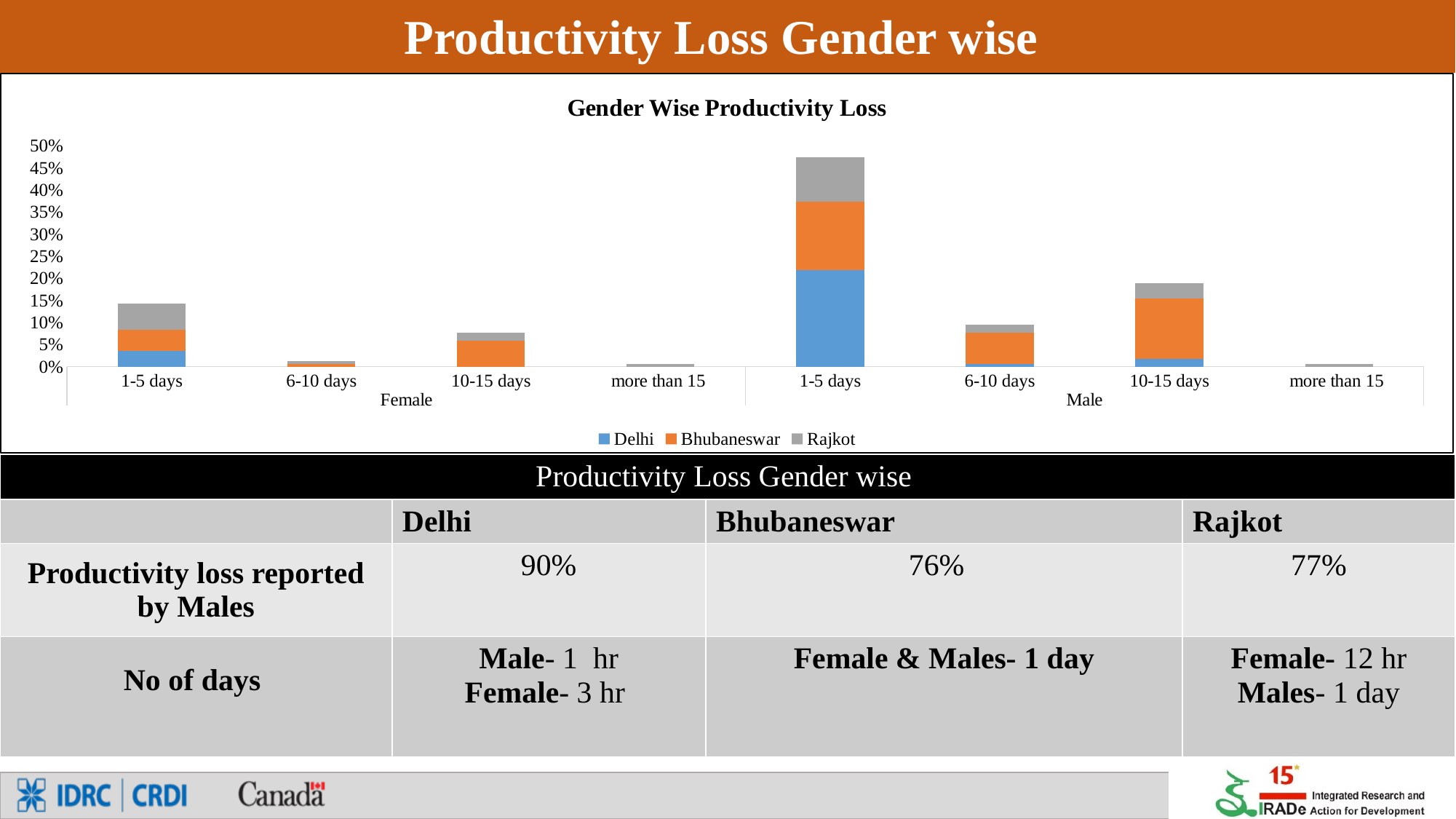
Which category has the tallest stacked bar in the chart? Male 1-5 days Is the total for the Female 1-5 days bar greater or less than 20%? less Is the total for the Female 6-10 days bar greater or less than 5%? less How many series does the chart legend list? 3 What is the title of the chart? Gender Wise Productivity Loss Which is larger, the total for Female 10-15 days or the total for Female 6-10 days? Female 10-15 days Which is larger, the total for Male 1-5 days or the total for Female 1-5 days? Male 1-5 days How many stacked bars are plotted in the chart? 8 What kind of chart is shown on the slide? Stacked bar chart Is the total for the Male 10-15 days bar greater or less than 15%? greater Which series are listed in the chart legend? Delhi, Bhubaneswar, Rajkot